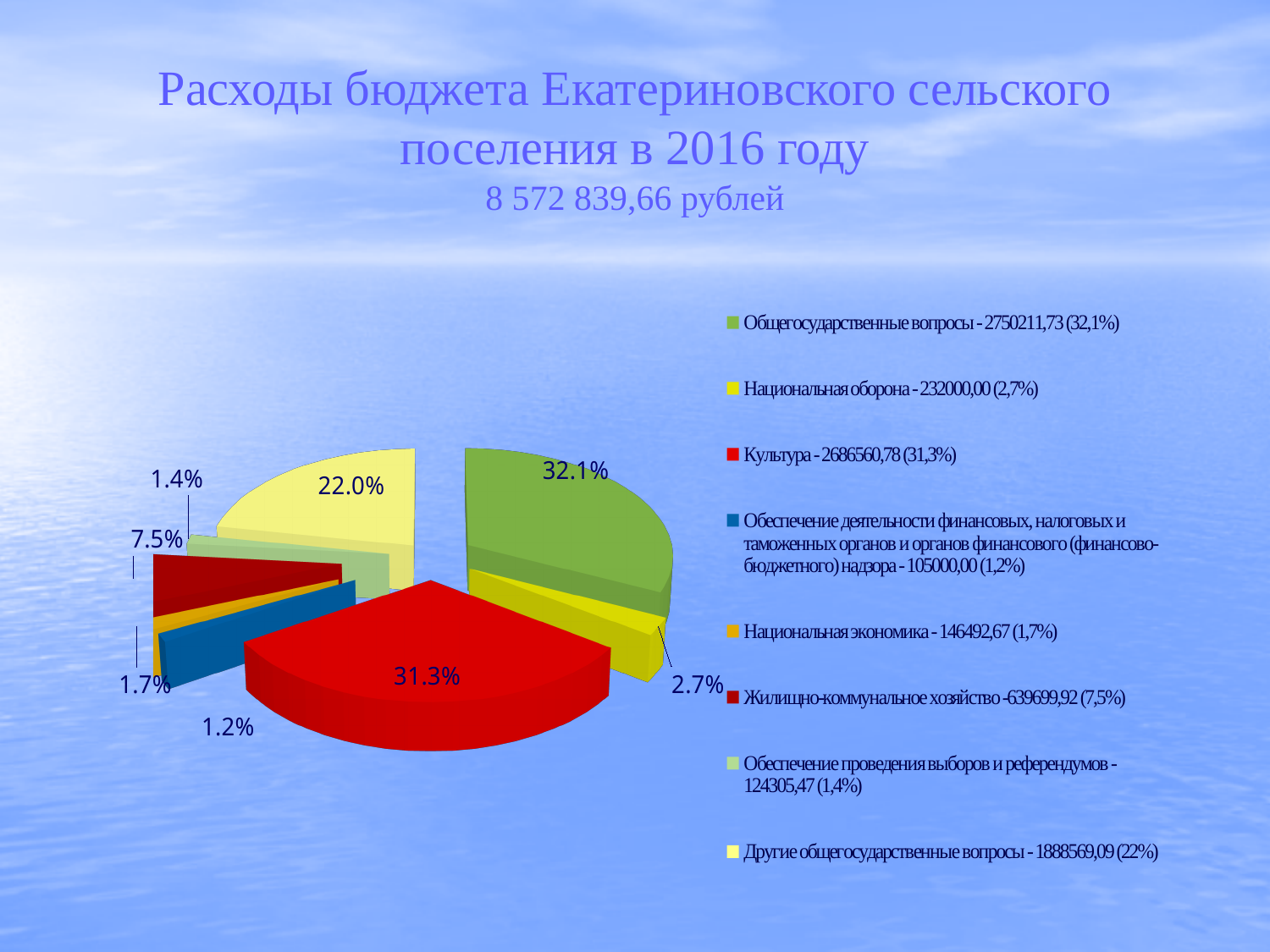
What percentage of the pie does Жилищно-коммунальное хозяйство account for? 7.5% Which has a larger share: Национальная оборона or Обеспечение проведения выборов и референдумов? Национальная оборона Which category has the smallest share of the pie? Обеспечение деятельности финансовых, налоговых и таможенных органов и органов финансового (финансово-бюджетного) надзора What total amount of budget expenditure is stated in the slide title? 8 572 839,66 рублей By how many percentage points does the share of Общегосударственные вопросы exceed the share of Культура? 0.8 What kind of chart is shown on the slide? pie chart How many slices does the pie chart have? 8 What percentage of the pie does Другие общегосударственные вопросы account for? 22.0% Which category has the largest share of the pie? Общегосударственные вопросы What percentage of the pie does Культура account for? 31.3% What is the amount shown in the legend for Национальная оборона? 232000,00 What is the amount shown in the legend for Национальная экономика? 146492,67